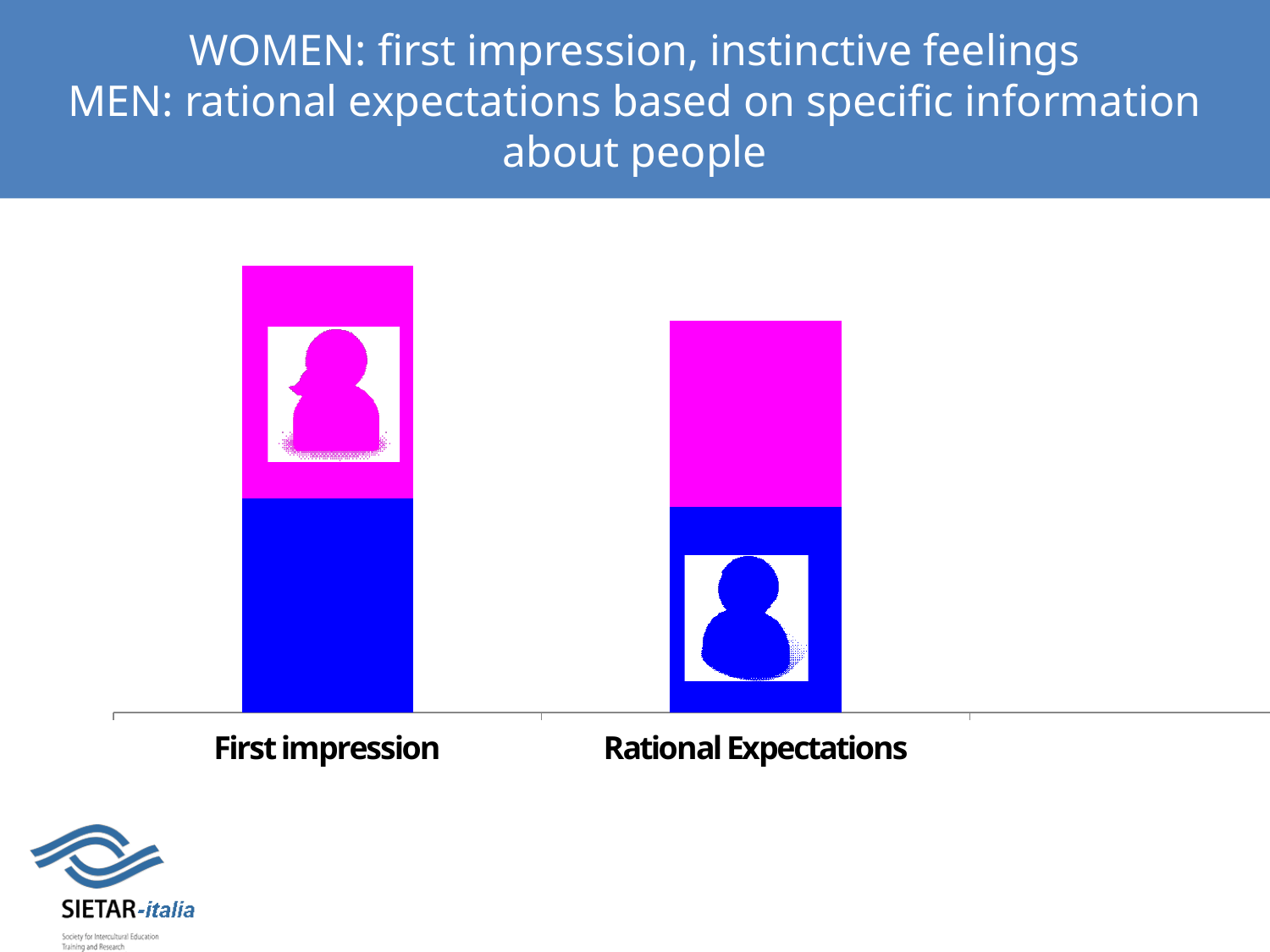
How many coloured segments does each stacked bar contain? 2 What two colours are used for the segments of the stacked bars? magenta and blue What are the two category labels on the x axis of the chart? First impression, Rational Expectations Which bar is taller overall, First impression or Rational Expectations? First impression How many categories are shown on the x axis of the chart? 2 Which category has the shortest bar overall? Rational Expectations What kind of chart is shown on the slide? bar chart